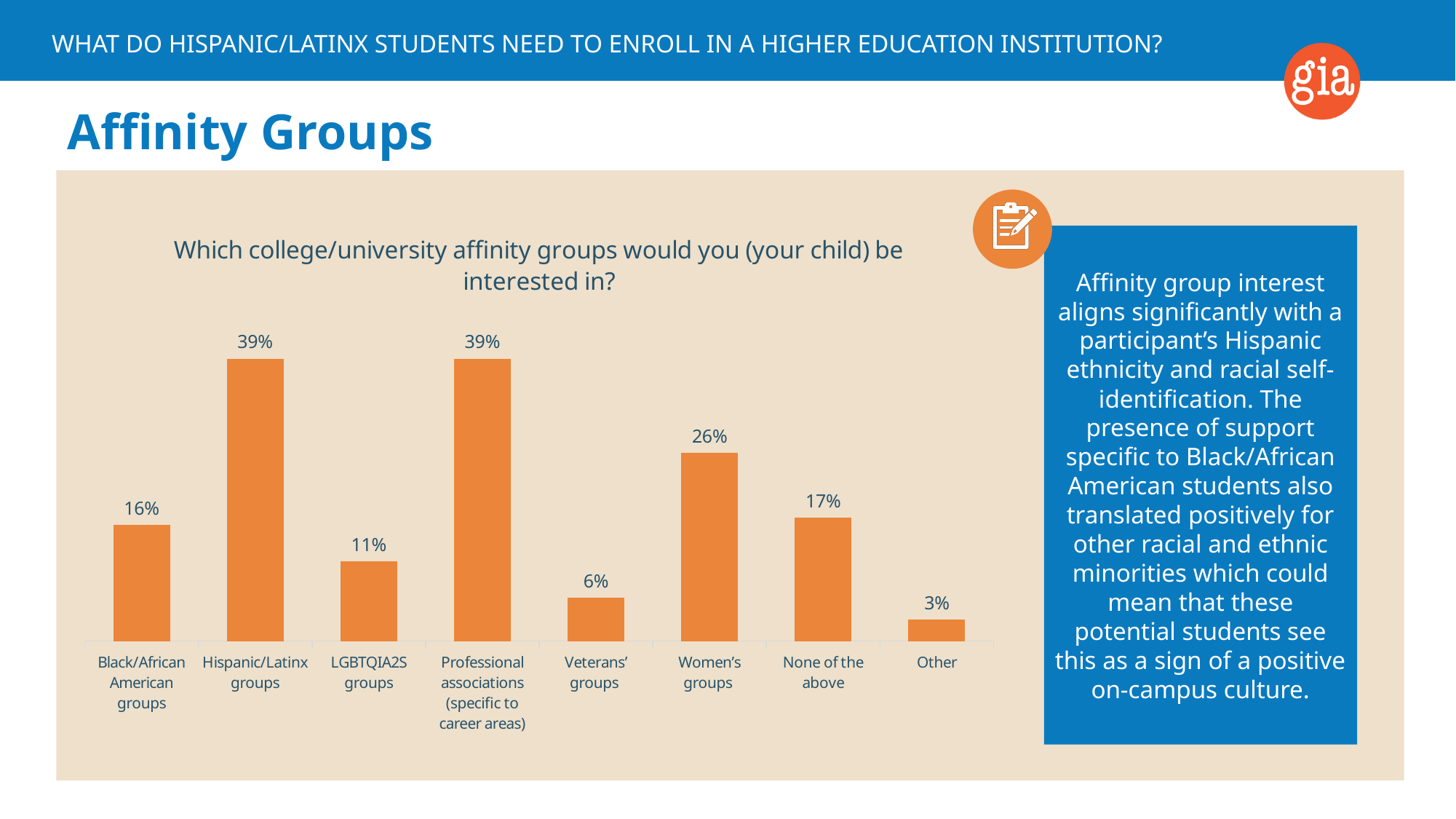
What value do both Hispanic/Latinx groups and Professional associations (specific to career areas) share? 39% What is the value shown for LGBTQIA2S groups? 11% What kind of chart is shown on the slide? Bar chart What is the difference between the values for Hispanic/Latinx groups and Women's groups? 13% Which is larger, the value for LGBTQIA2S groups or the value for Veterans' groups? LGBTQIA2S groups What percentage of respondents would be interested in Women's groups? 26% How many categories are shown in the chart? 8 Which category has the lowest value in the chart? Other What is the title of the chart? Which college/university affinity groups would you (your child) be interested in? What percentage is shown for Black/African American groups? 16% What is the difference between the values for None of the above and Black/African American groups? 1% What is the value for Veterans' groups? 6%